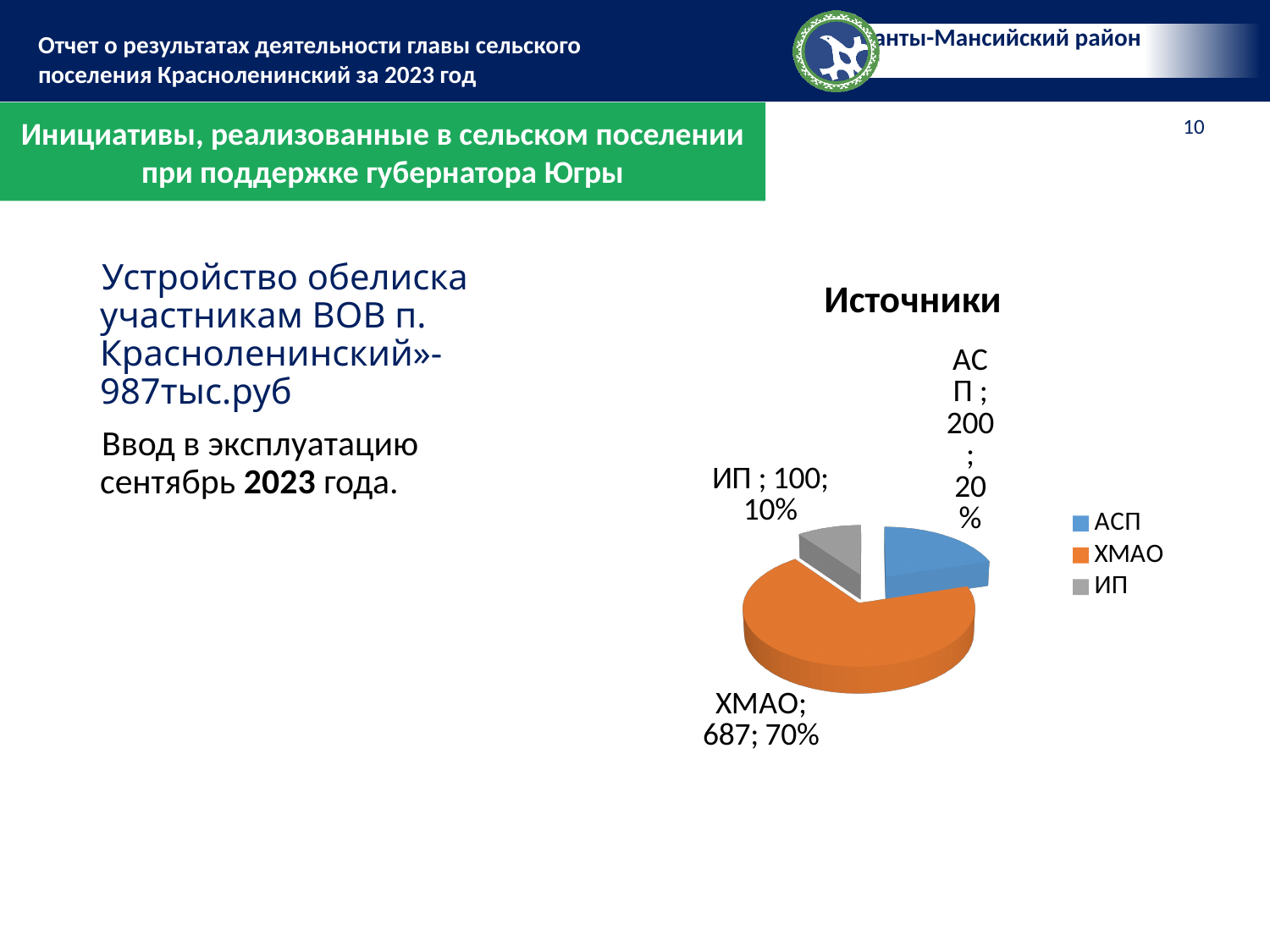
What is the difference between the values for ХМАО and АСП? 487 What is the value for ИП? 100 What share of the pie does ИП account for? 10% How many slices does the pie chart have? 3 What is the value for АСП? 200 What share of the pie does ХМАО account for? 70% How many entries does the legend list? 3 Which source has the smallest slice? ИП What is the value for ХМАО? 687 What is the title of the chart? Источники Which source has the largest slice? ХМАО What type of chart is shown on the slide? pie chart